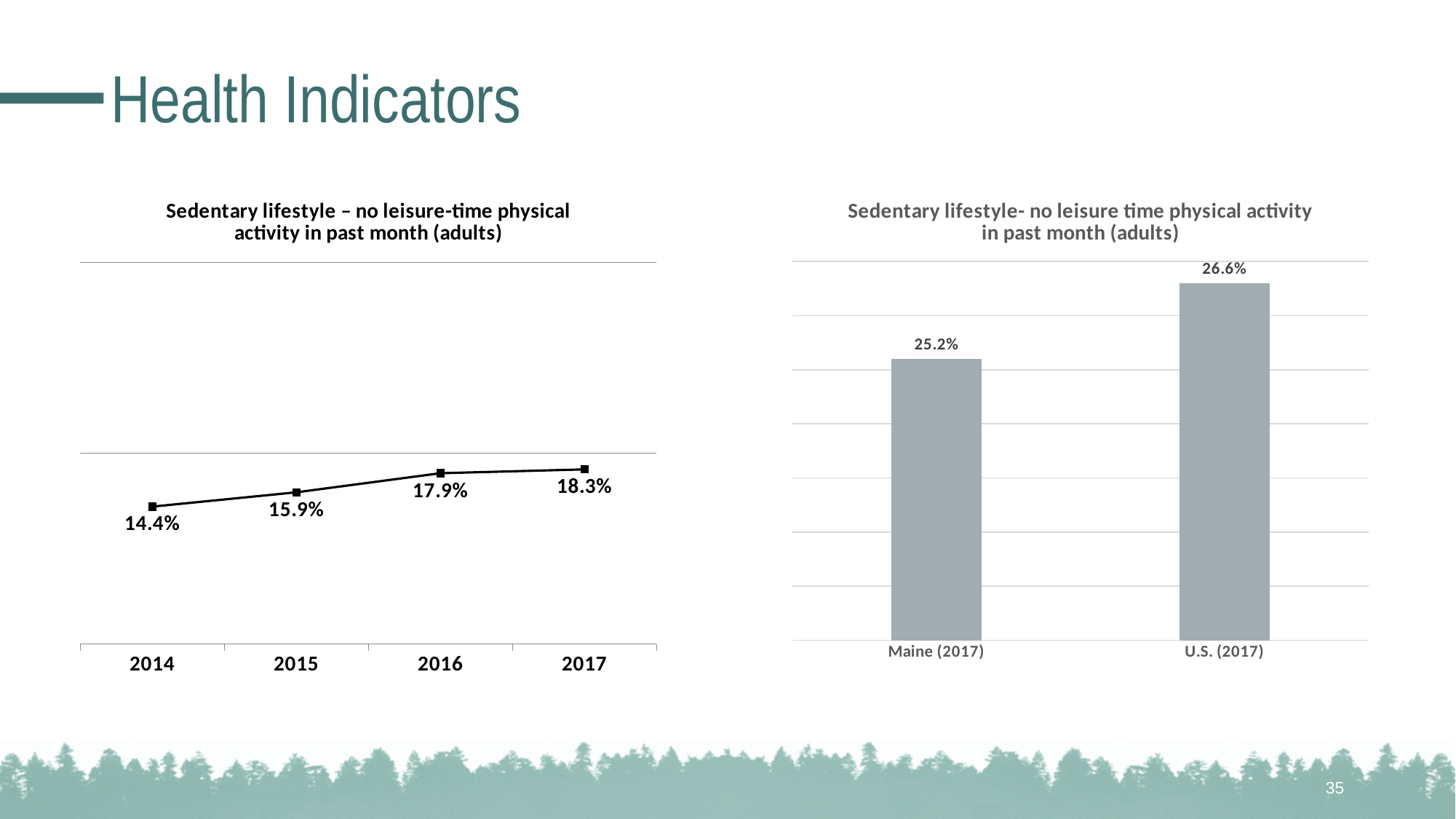
In the left chart, what is the value for 2016? 17.9% What kind of chart is the right chart? bar chart In the right chart, what is the difference between the U.S. (2017) and Maine (2017) values? 1.4% How many data points are plotted in the left chart? 4 In the left chart, what is the difference between the 2017 and 2014 values? 3.9% In the right chart, which is larger, Maine (2017) or U.S. (2017)? U.S. (2017) In the left chart, which year has the highest value? 2017 What kind of chart is the left chart? line chart In the left chart, which year has the lowest value? 2014 In the right chart, what is the value for Maine (2017)? 25.2% In the left chart, what is the value for 2014? 14.4% In the left chart, do the values rise or fall from 2014 to 2017? rise